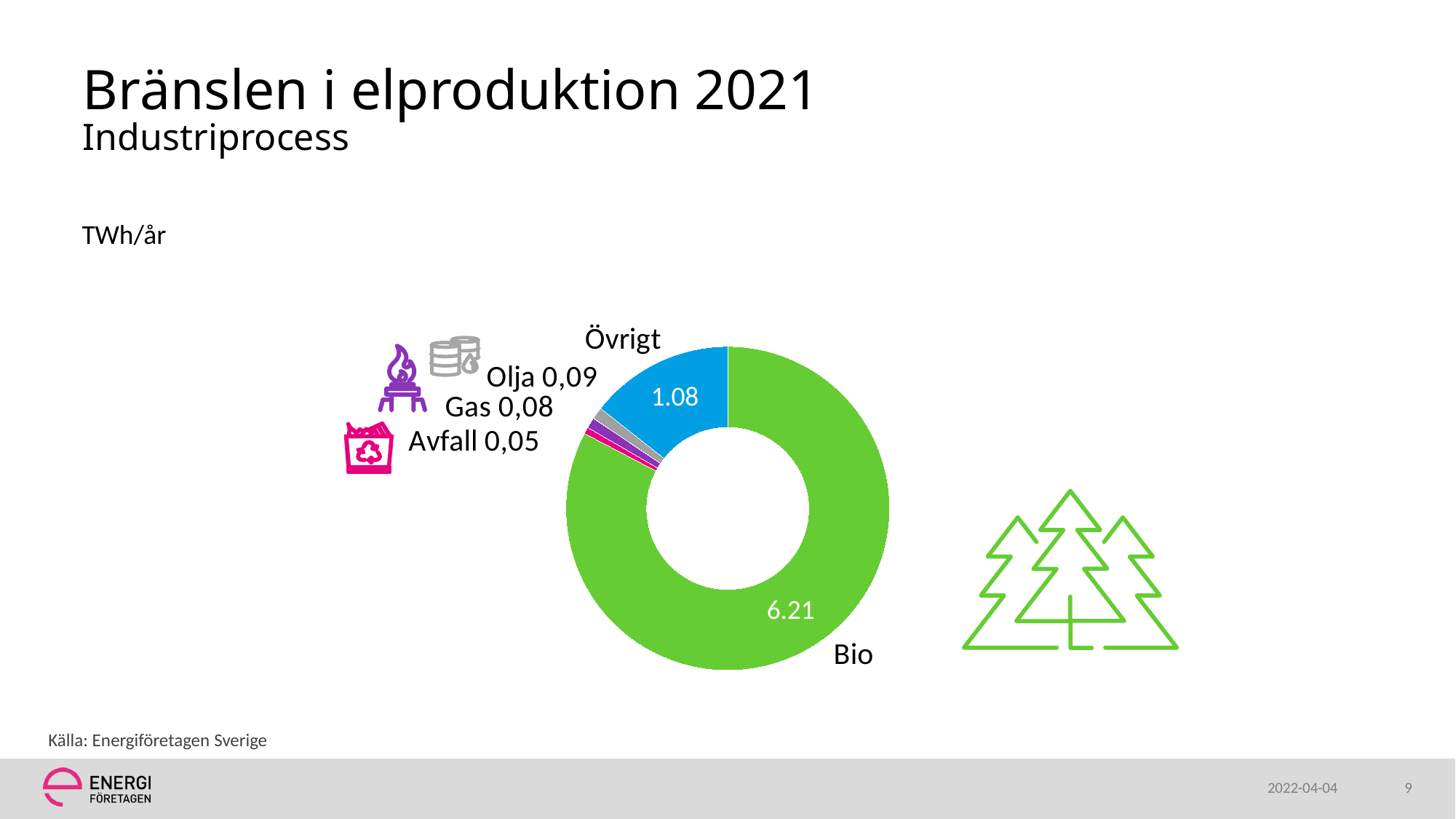
What is the difference between the values for Bio and Övrigt? 5.13 What is the value for Övrigt in the chart? 1.08 What is the value for Gas in the chart? 0,08 What is the value for Bio in the chart? 6.21 Which category has the largest value in the chart? Bio What is the value for Avfall in the chart? 0,05 What kind of chart is shown on the slide? donut chart Which is larger, the value for Olja or the value for Gas? Olja What is the value for Olja in the chart? 0,09 How many categories are shown in the chart? 5 What unit are the chart values given in? TWh/år Which category has the smallest value in the chart? Avfall